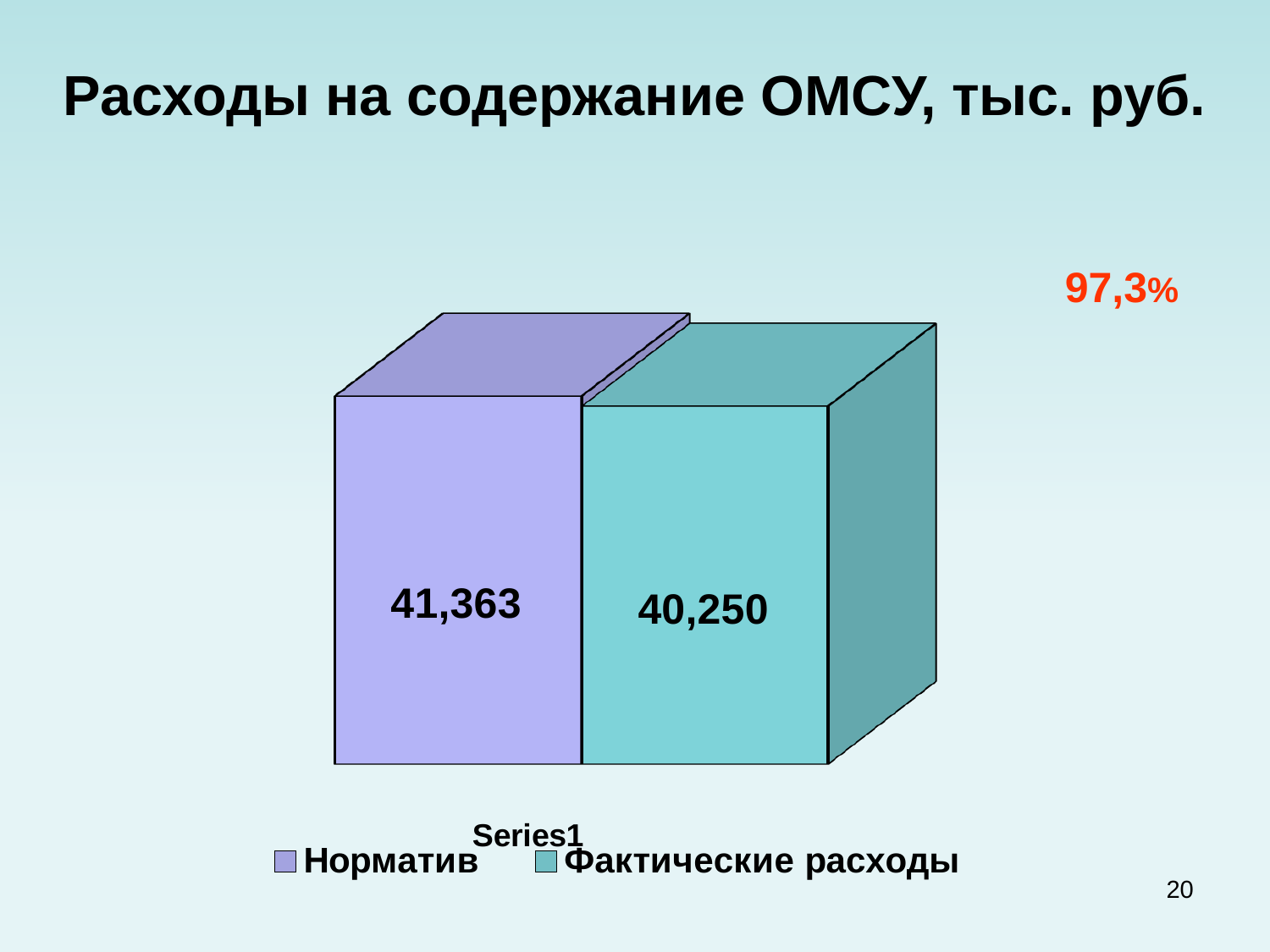
What is the value for Фактические расходы? 40,250 What percentage is printed in red at the top right of the chart? 97,3% Which series has the higher value, Норматив or Фактические расходы? Норматив Which series has the lower value? Фактические расходы Is the value for Норматив larger or smaller than the value for Фактические расходы? larger How many bars are plotted in the chart? 2 What kind of chart is shown on the slide? bar chart What is the title of the chart on the slide? Расходы на содержание ОМСУ, тыс. руб. What is the difference between the Норматив value and the Фактические расходы value? 1,113 How many series does the legend list? 2 What is the value for Норматив? 41,363